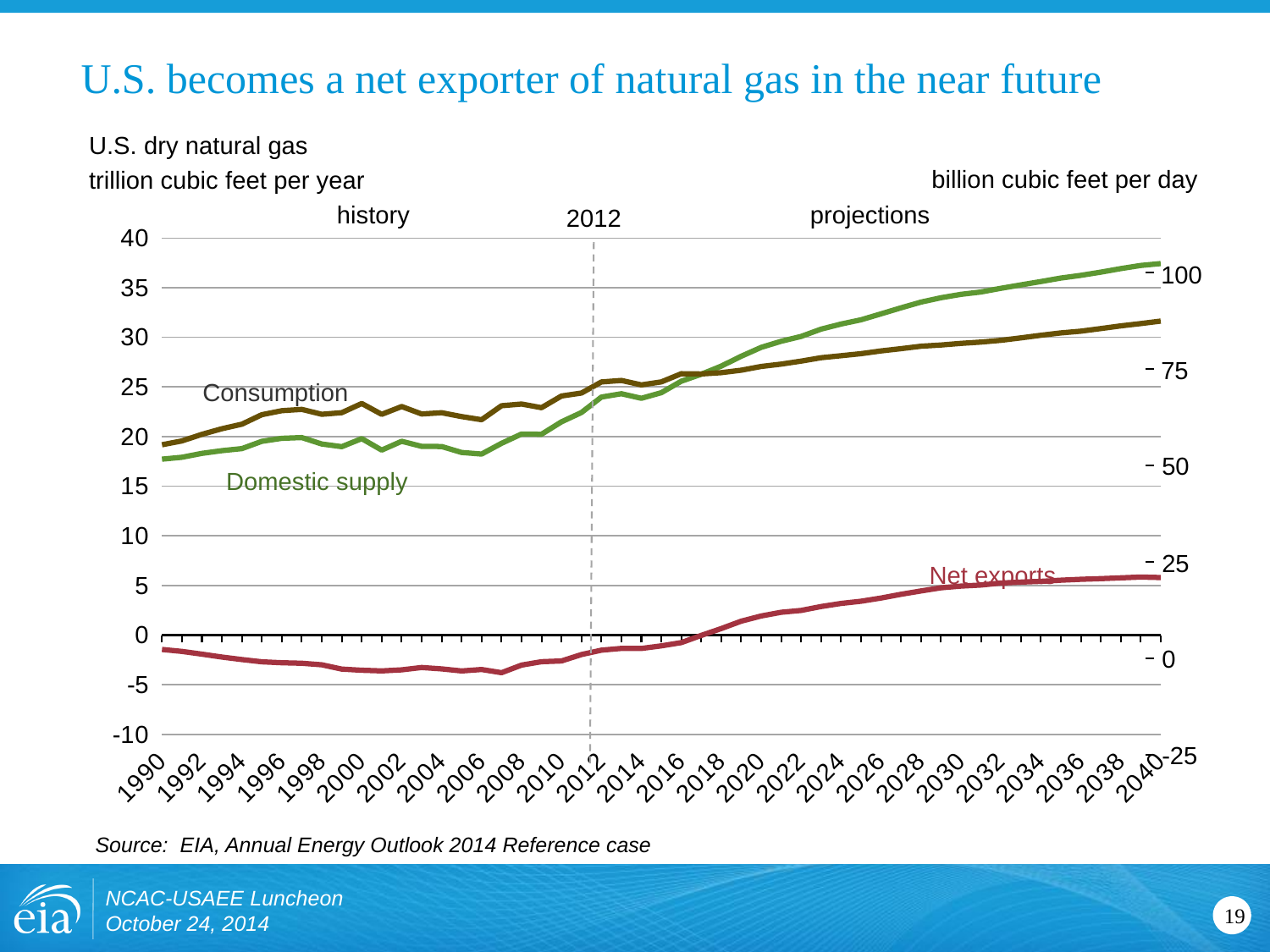
Which series is higher in 1990, Consumption or Domestic supply? Consumption Does the Net exports line rise or fall between 2012 and 2040? rise Does the Domestic supply line rise or fall between 2012 and 2040? rise Which series is higher in 2040, Domestic supply or Consumption? Domestic supply Is the value for Domestic supply in 2006 greater or less than 20 trillion cubic feet per year? less What unit is shown on the right-hand axis of the chart? billion cubic feet per day How many data series are labeled on the chart? 3 Is the value for Consumption in 2040 greater or less than 30 trillion cubic feet per year? greater What kind of chart is shown on the slide? line chart Is the value for Net exports in 1990 greater or less than 0? less Which year does the dashed vertical line separating history from projections mark? 2012